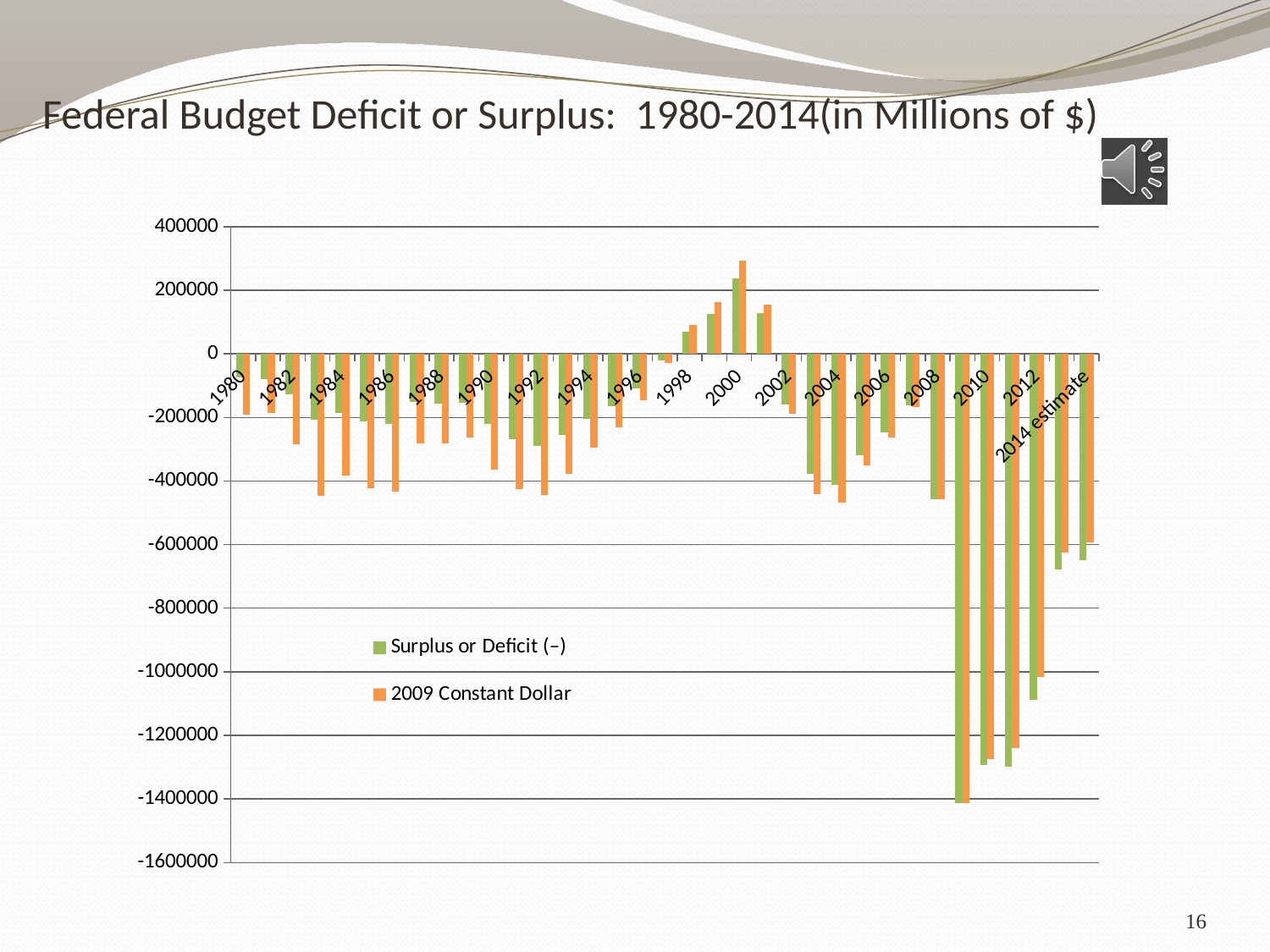
In which year is the Surplus or Deficit (–) value the lowest? 2009 Which year has the larger Surplus or Deficit (–) value, 1998 or 2000? 2000 What are the two series named in the legend? Surplus or Deficit (–) and 2009 Constant Dollar How many series does the legend list? 2 Is the Surplus or Deficit (–) value for 2009 greater or less than -1200000? less Which year has the larger 2009 Constant Dollar value, 2009 or 2013? 2013 Is the 2009 Constant Dollar value for 2004 greater or less than -400000? less Is the 2009 Constant Dollar value for 2000 greater or less than 200000? greater What kind of chart is shown on the slide? bar chart In which year is the Surplus or Deficit (–) value the highest? 2000 What is the title of the chart? Federal Budget Deficit or Surplus: 1980-2014(in Millions of $)